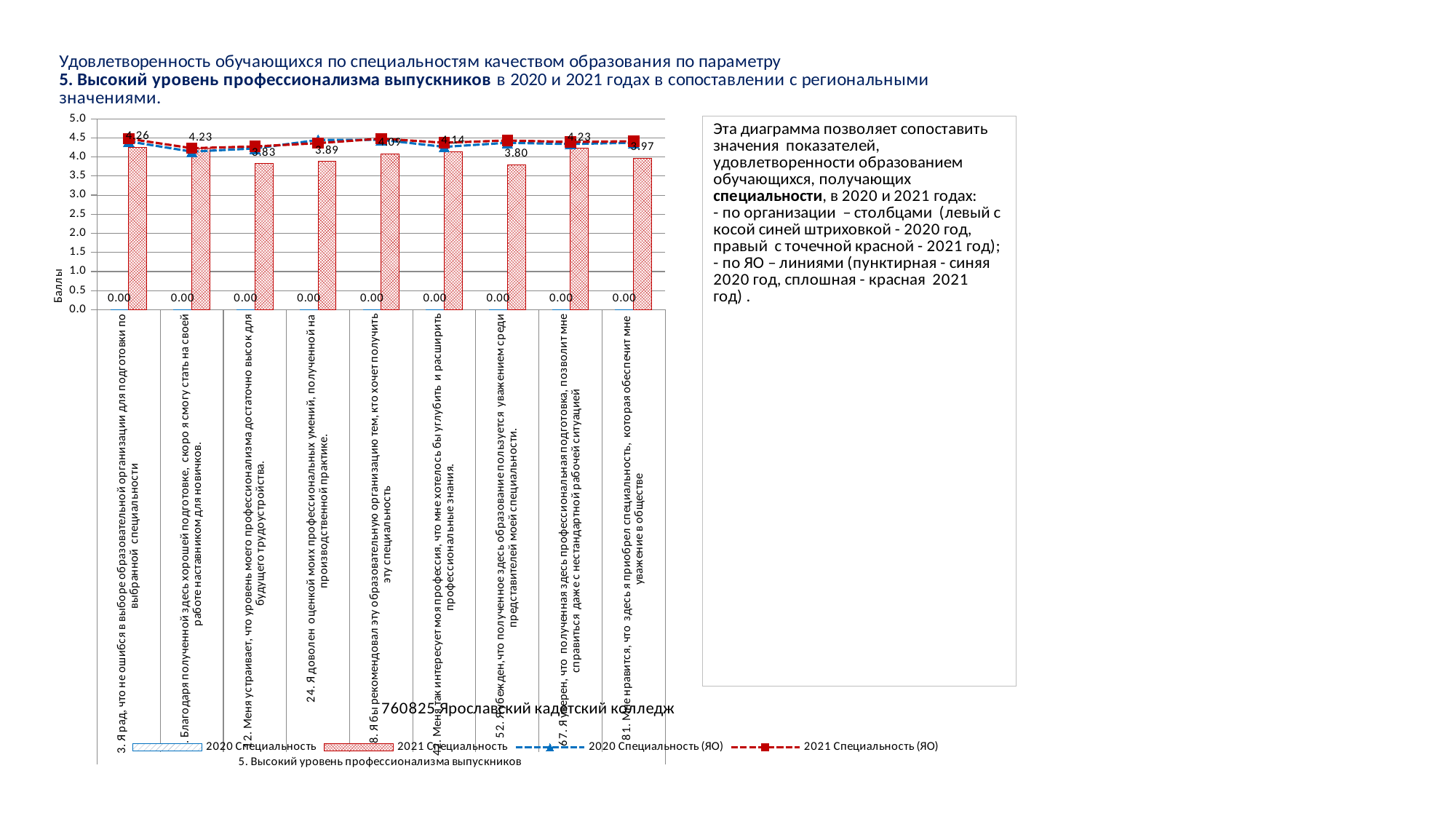
What is the title of the vertical axis of the chart? Баллы What is the value of the 2021 Специальность bar for the category "81. Мне нравится, что здесь я приобрел специальность, которая обеспечит мне уважение в обществе"? 3.97 What is the value of the 2021 Специальность bar for the category "52. Я убежден, что полученное здесь образование пользуется уважением среди представителей моей специальности."? 3.80 Is the 2021 Специальность (ЯО) line value for the category "52. Я убежден, что полученное здесь образование пользуется уважением среди представителей моей специальности." greater or less than 4.0? greater How many series does the chart legend list? 4 What is the value of the 2021 Специальность bar for the category "24. Я доволен оценкой моих профессиональных умений, полученной на производственной практике."? 3.89 What is the difference between the highest (4.26) and lowest (3.80) 2021 Специальность bar values? 0.46 Which category has the lowest 2021 Специальность bar? 52. Я убежден, что полученное здесь образование пользуется уважением среди представителей моей специальности. What value is labelled on every 2020 Специальность bar? 0.00 Which 2021 Специальность bar is larger: the one for "2. Меня устраивает, что уровень моего профессионализма достаточно высок для будущего трудоустройства." or the one for "24. Я доволен оценкой моих профессиональных умений, полученной на производственной практике."? 24. Я доволен оценкой моих профессиональных умений, полученной на производственной практике. How many categories are shown on the x axis of the chart? 9 Which category has the highest 2021 Специальность bar? 3. Я рад, что не ошибся в выборе образовательной организации для подготовки по выбранной специальности